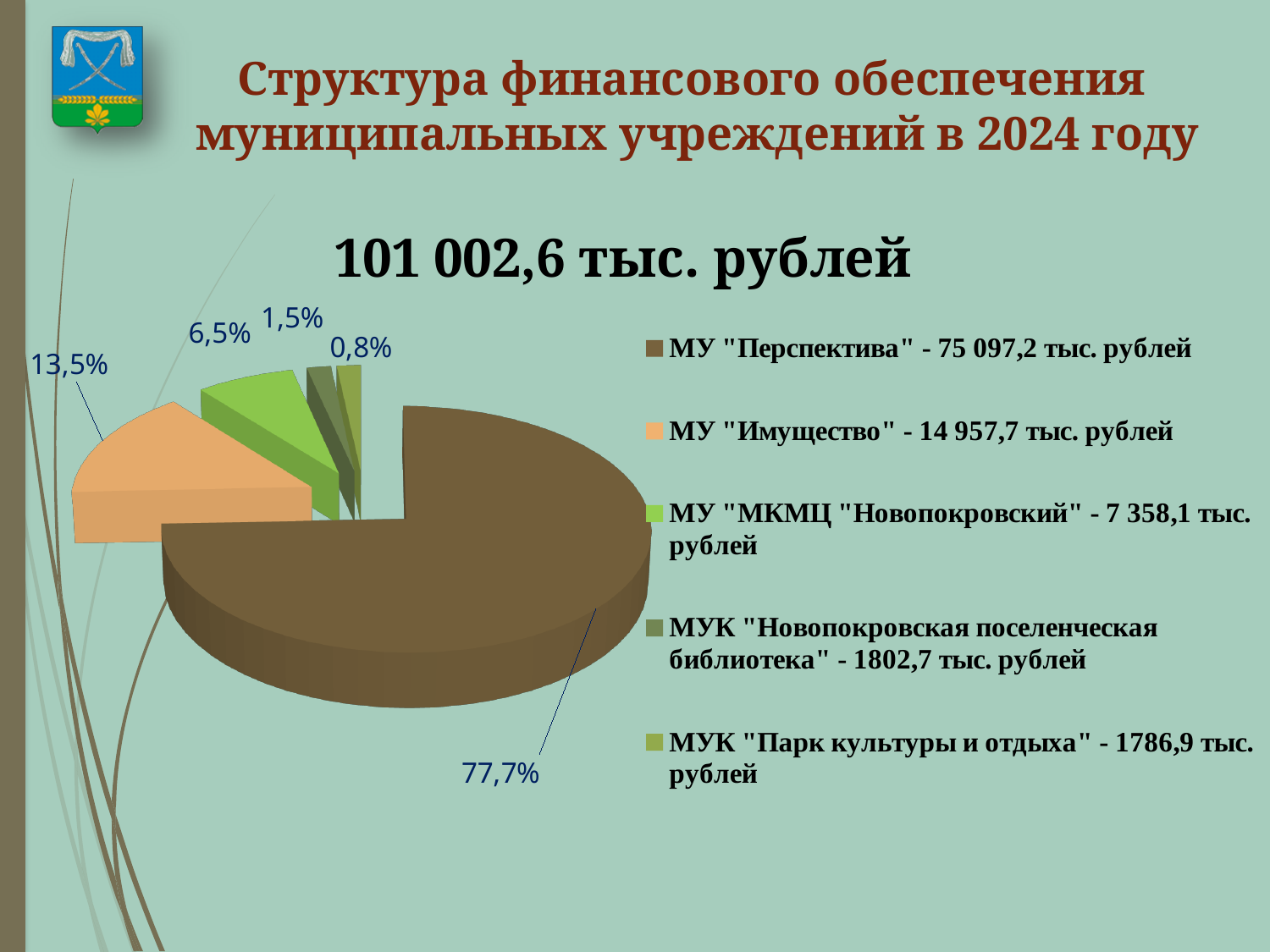
What is the difference in percentage points between the shares of МУ "Перспектива" and МУ "Имущество"? 64,2 What kind of chart is shown on the slide? pie chart What is the amount shown in the legend for МУК "Новопокровская поселенческая библиотека"? 1802,7 тыс. рублей What share of the pie does МУ "Перспектива" account for? 77,7% How many slices does the pie chart have? 5 What share of the pie does МУ "Имущество" account for? 13,5% Which category has the smallest share of the pie? МУК "Парк культуры и отдыха" Which has the larger share: МУ "Имущество" or МУ "МКМЦ "Новопокровский"? МУ "Имущество" What is the amount shown in the legend for МУ "Имущество"? 14 957,7 тыс. рублей Which category has the largest share of the pie? МУ "Перспектива" What share of the pie does МУ "МКМЦ "Новопокровский" account for? 6,5%